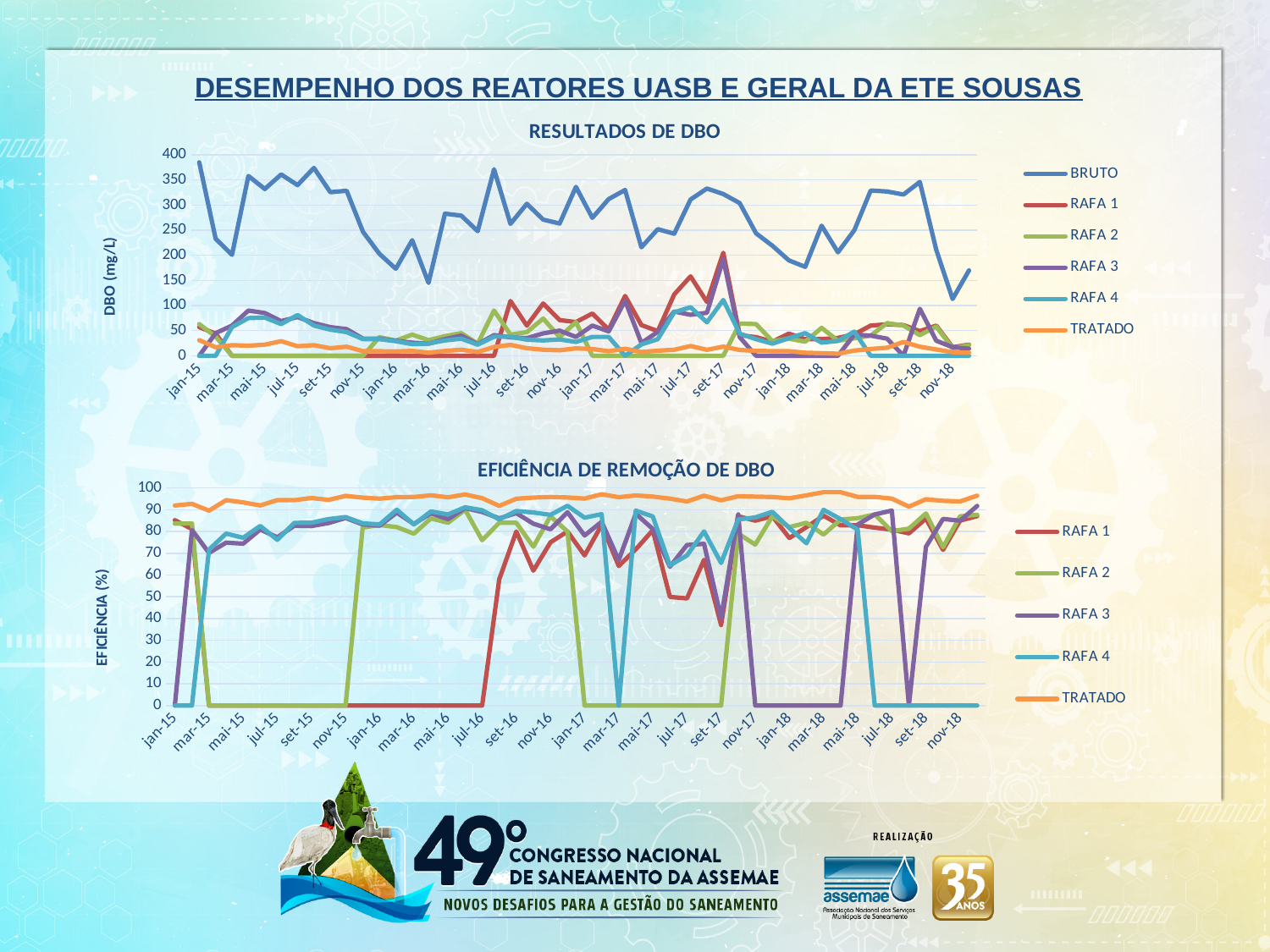
What is the y-axis title of the 'RESULTADOS DE DBO' chart? DBO (mg/L) What is the y-axis title of the 'EFICIÊNCIA DE REMOÇÃO DE DBO' chart? EFICIÊNCIA (%) How many series does the legend of the 'EFICIÊNCIA DE REMOÇÃO DE DBO' chart list? 5 What kind of chart is the 'EFICIÊNCIA DE REMOÇÃO DE DBO' chart? Line chart What kind of chart is the 'RESULTADOS DE DBO' chart? Line chart In the 'RESULTADOS DE DBO' chart, is the BRUTO value for jan-15 greater or less than 350? greater In the 'RESULTADOS DE DBO' chart, which is larger at jan-15, BRUTO or TRATADO? BRUTO In the 'RESULTADOS DE DBO' chart, which series has the highest values over the period? BRUTO In the 'EFICIÊNCIA DE REMOÇÃO DE DBO' chart, which series has the highest values over the period? TRATADO In the 'EFICIÊNCIA DE REMOÇÃO DE DBO' chart, is the TRATADO value for jan-15 greater or less than 80? greater In the 'RESULTADOS DE DBO' chart, is the TRATADO value for jan-15 greater or less than 100? less How many series does the legend of the 'RESULTADOS DE DBO' chart list? 6